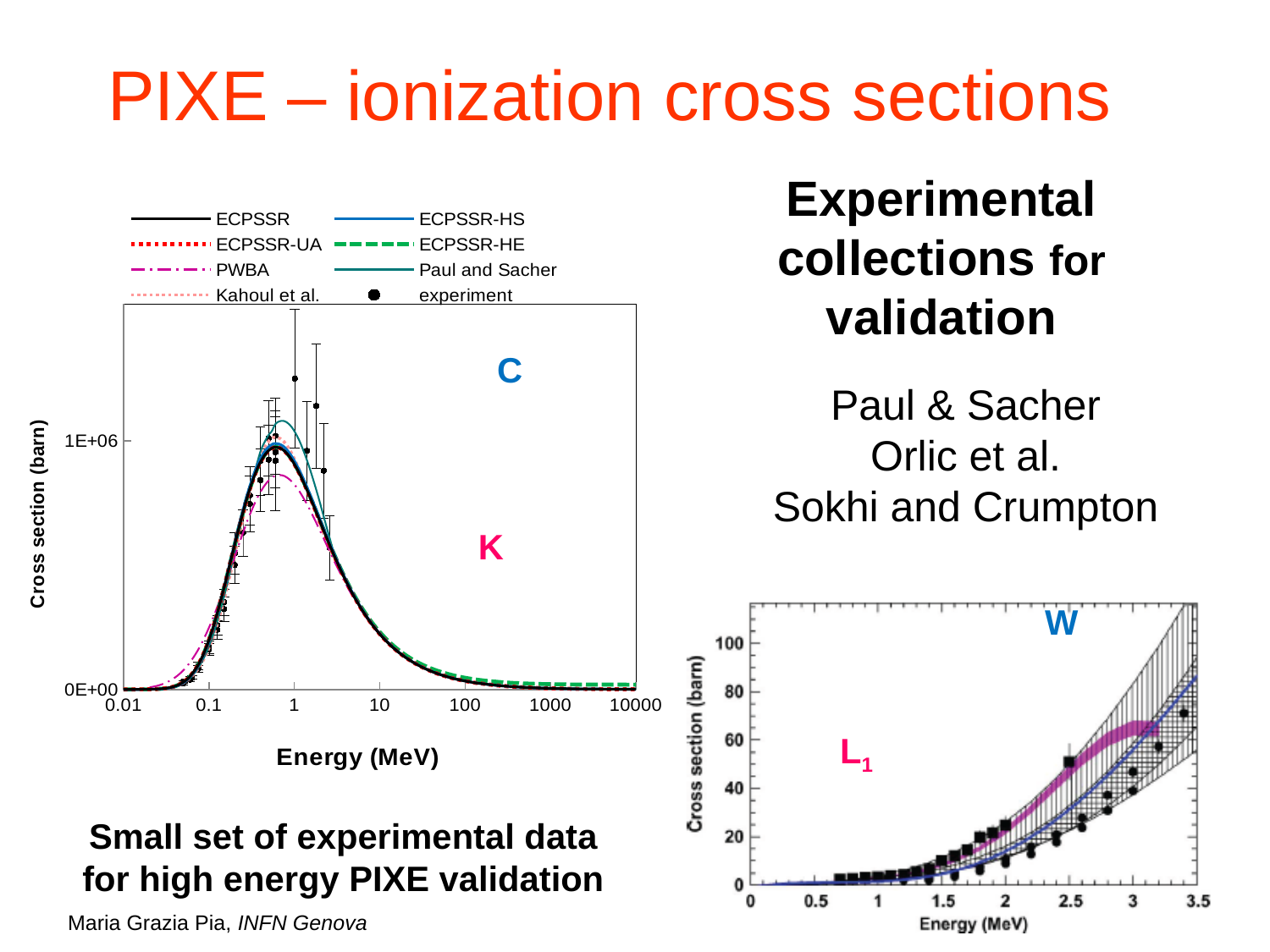
What kind of chart is the chart on the left of the slide? line chart In the bottom-right chart, does the cross section rise or fall as energy increases from 0.5 MeV to 3.5 MeV? rise In the left chart, is the cross section at 0.01 MeV greater or less than 1E+06 barn? less In the bottom-right chart, is the cross section at 3 MeV greater or less than 20 barn? greater In the left chart, which legend entry is shown with dot markers instead of a line? experiment How many series does the legend of the left chart list? 8 What is the y-axis label of the left chart? Cross section (barn) In the left chart, do the curves rise or fall as energy increases from 1 MeV to 10000 MeV? fall How many tick labels are printed on the x axis of the left chart? 7 In the bottom-right chart, is the cross section at 1 MeV greater or less than 20 barn? less What is the highest tick label on the y axis of the bottom-right chart? 100